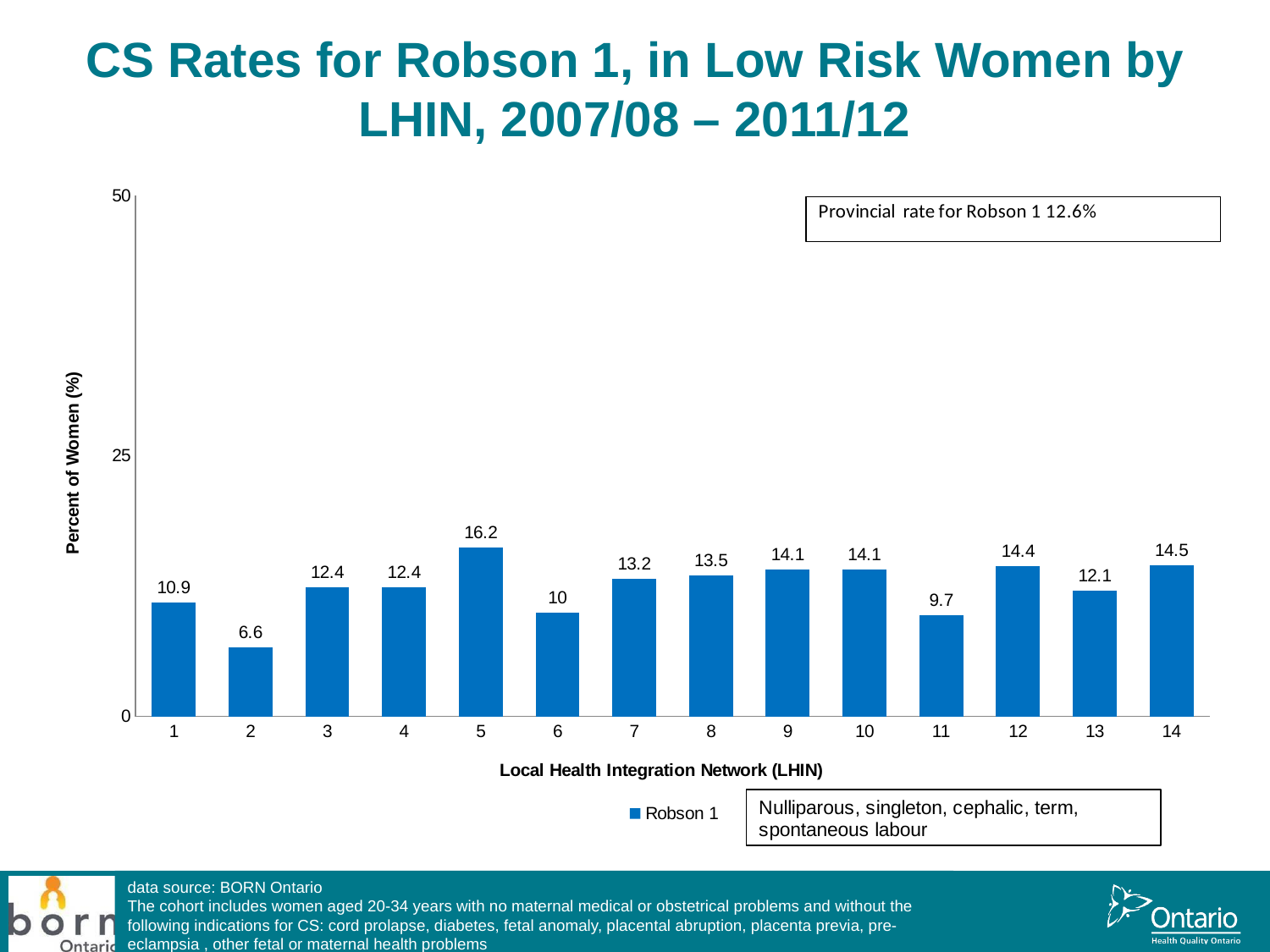
What is the difference between the CS rates for LHIN 5 and LHIN 2? 9.6 How many series does the legend list? 1 Is the CS rate for LHIN 5 greater or less than 25? less Which LHIN has the highest CS rate? 5 What is the CS rate for LHIN 11? 9.7 What is the CS rate for LHIN 5? 16.2 Which LHIN has the lowest CS rate? 2 How many LHINs are shown on the x axis? 14 What kind of chart is shown on the slide? bar chart Which has a higher CS rate, LHIN 14 or LHIN 13? LHIN 14 What is the CS rate for LHIN 2? 6.6 What is the provincial rate for Robson 1 stated on the chart? 12.6%